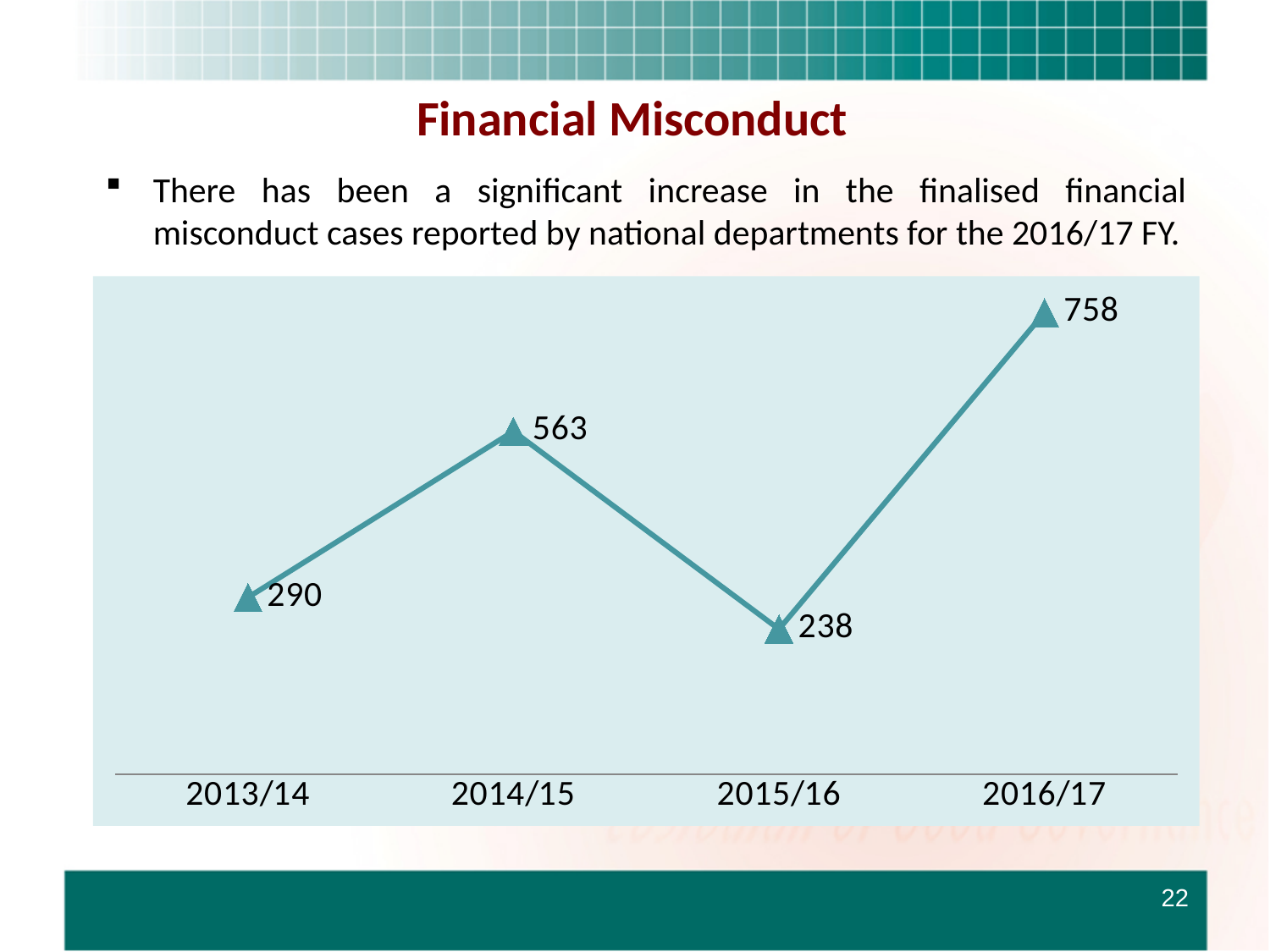
Which year has the lowest value? 2015/16 Does the value rise or fall from 2014/15 to 2015/16? Fall What is the value for 2016/17? 758 What kind of chart is shown on the slide? Line chart What is the value for 2015/16? 238 What is the difference between the values for 2016/17 and 2015/16? 520 What is the value for 2014/15? 563 Which is larger, the value for 2014/15 or the value for 2016/17? 2016/17 What is the value for 2013/14? 290 How many data points are plotted on the chart? 4 What is the difference between the values for 2014/15 and 2013/14? 273 Which year has the highest value? 2016/17